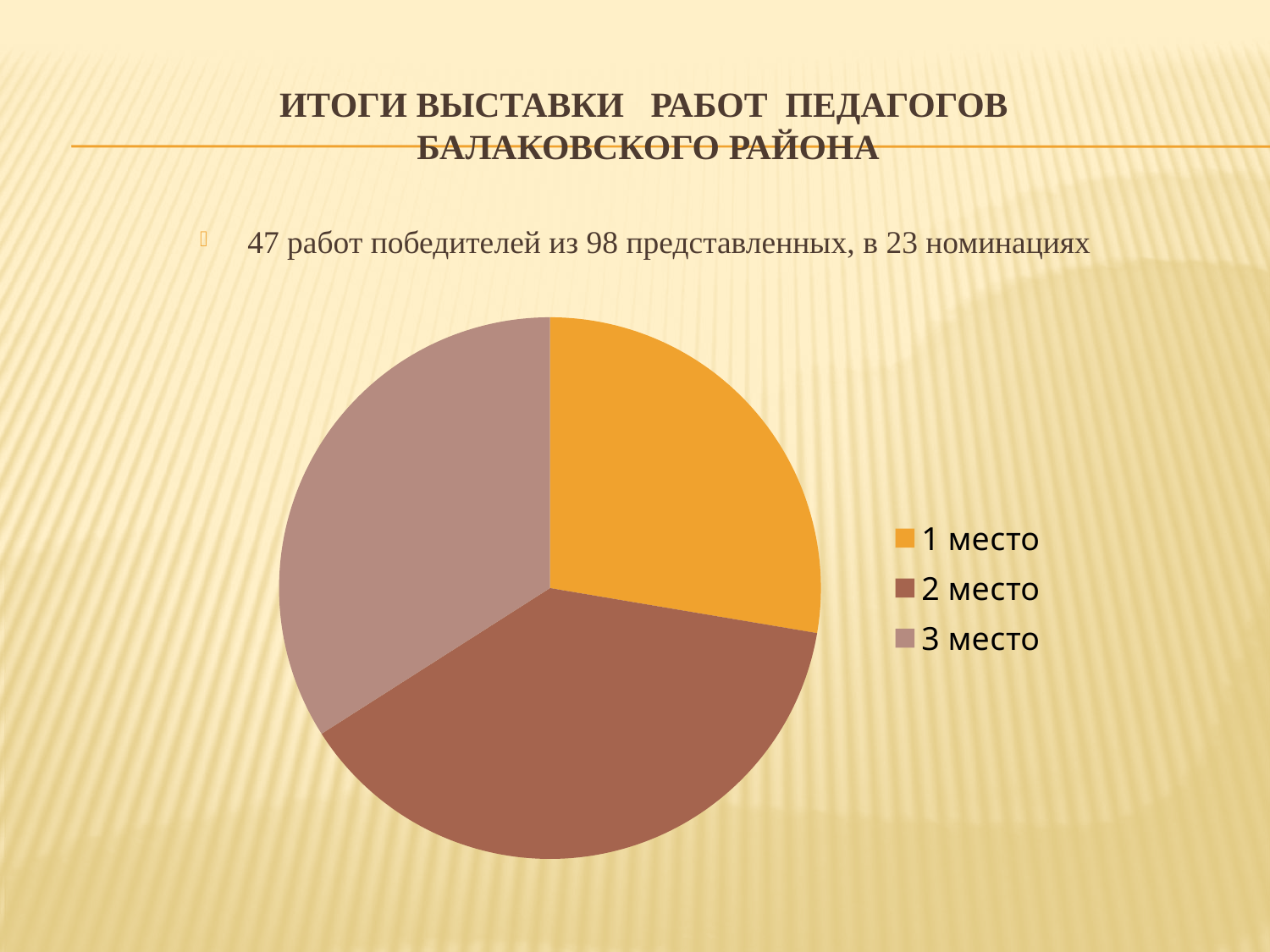
How many entries does the legend of the pie chart list? 3 What colour is the slice for 1 место in the pie chart? orange What kind of chart is shown on the slide? pie chart Which slice is larger in the pie chart, 1 место or 3 место? 3 место How many slices does the pie chart have? 3 What are the legend entries of the pie chart, in order? 1 место, 2 место, 3 место Which category has the smallest slice in the pie chart? 1 место Which slice is larger in the pie chart, 1 место or 2 место? 2 место